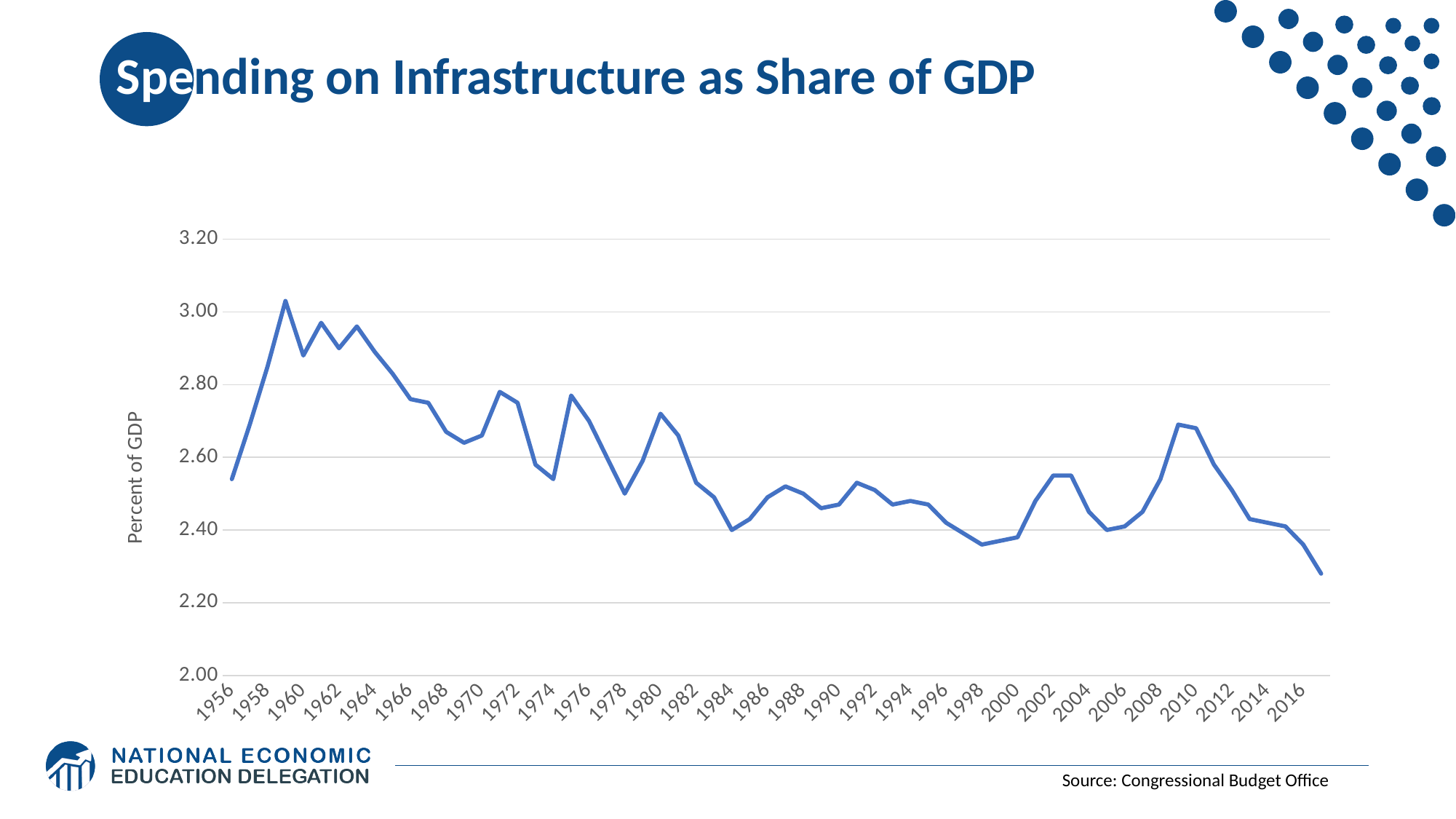
Which year has the larger value, 1960 or 2010? 1960 Is the highest point on the line greater or less than 3.00? greater What is the label on the vertical axis? Percent of GDP What is the source cited for the chart? Congressional Budget Office Is the value for 1990 greater or less than 2.60? less Which year has the larger value, 1972 or 1974? 1972 Is the value for 1972 greater or less than 2.60? greater What kind of chart is shown on the slide? line chart Overall, do the values rise or fall from 1956 to the end of the series? fall